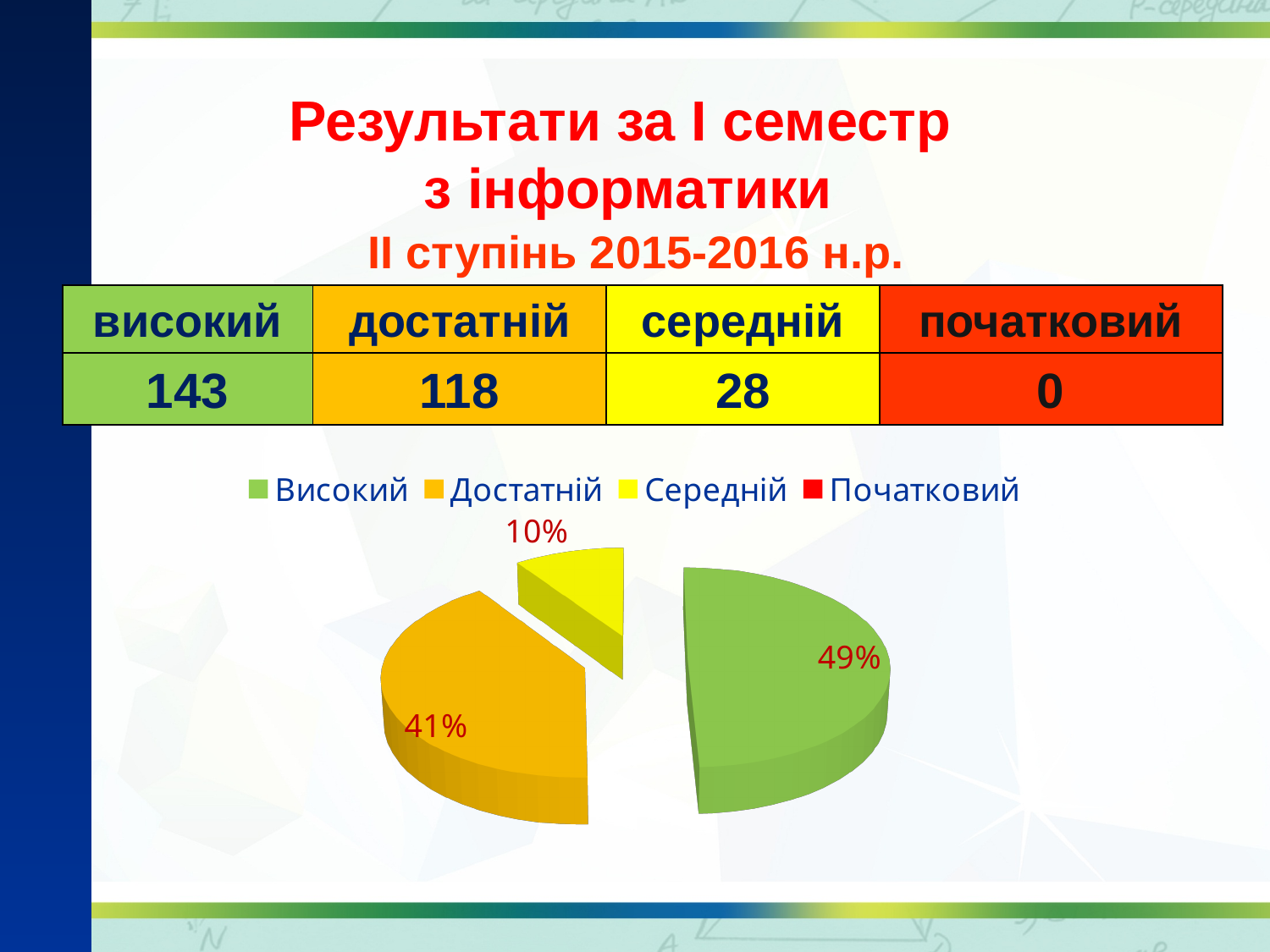
What colour is the Високий slice in the pie chart? green What percentage of the pie does the Середній slice represent? 10% By how many percentage points does the Достатній slice exceed the Середній slice? 31% What percentage of the pie does the Достатній slice represent? 41% Of the slices drawn in the pie chart, which is the smallest? Середній How many entries does the legend of the pie chart list? 4 What kind of chart is shown on the slide? pie chart Which slice is larger in the pie chart, Середній or Достатній? Достатній Which slice is larger in the pie chart, Високий or Достатній? Високий Which slice of the pie chart is the largest? Високий By how many percentage points does the Високий slice exceed the Достатній slice? 8% What percentage of the pie does the Високий slice represent? 49%